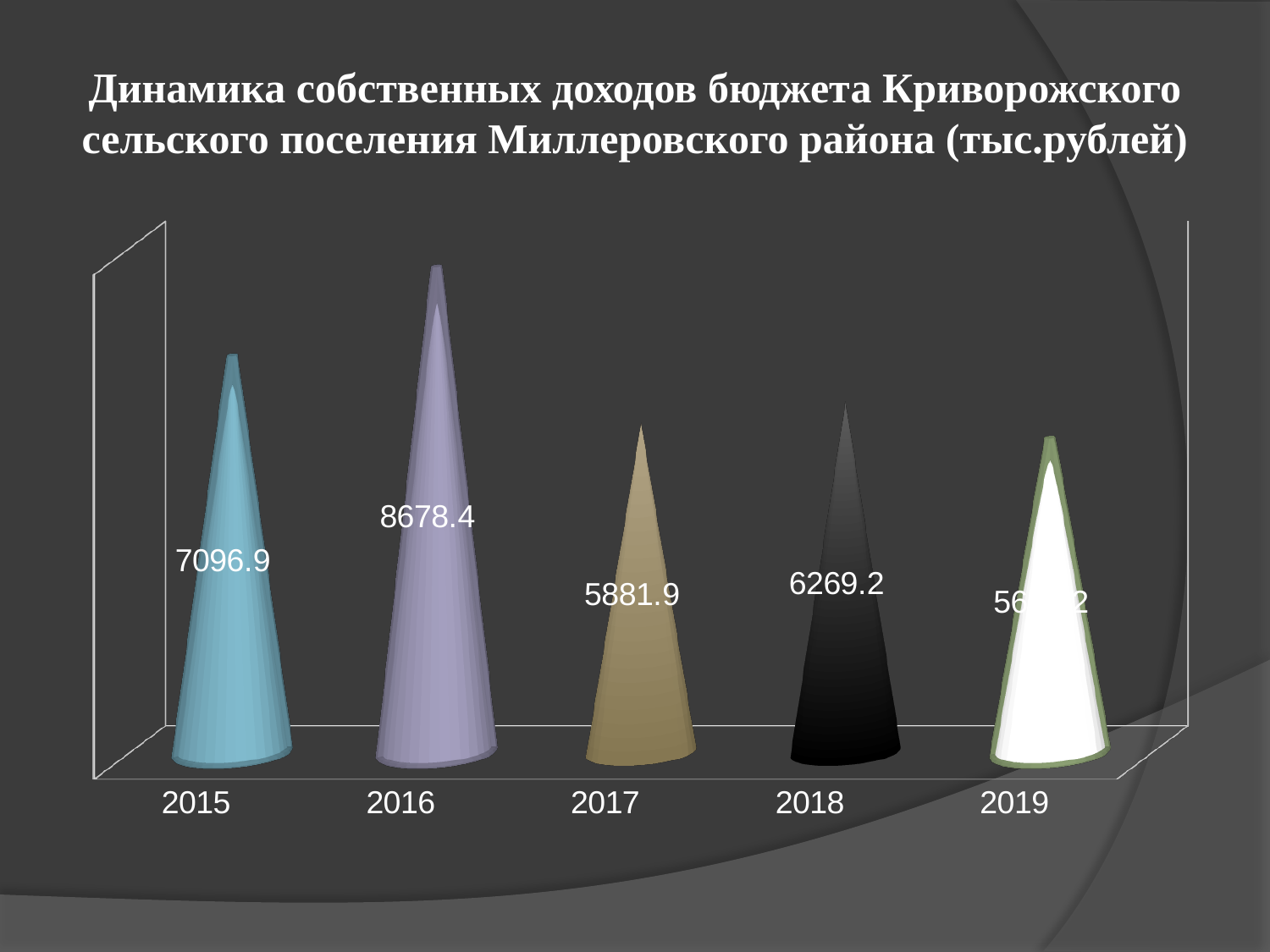
Which is larger, the value for 2015 or the value for 2016? 2016 What is the value for 2018? 6269.2 What is the difference between the values for 2018 and 2017? 387.3 Which year has the highest value? 2016 Which is larger, the value for 2017 or the value for 2018? 2018 What is the difference between the values for 2016 and 2015? 1581.5 What is the value for 2016? 8678.4 Does the value rise or fall from 2016 to 2017? fall What kind of chart is shown on the slide? bar chart What is the value for 2015? 7096.9 How many years are shown on the x axis? 5 What is the value for 2017? 5881.9